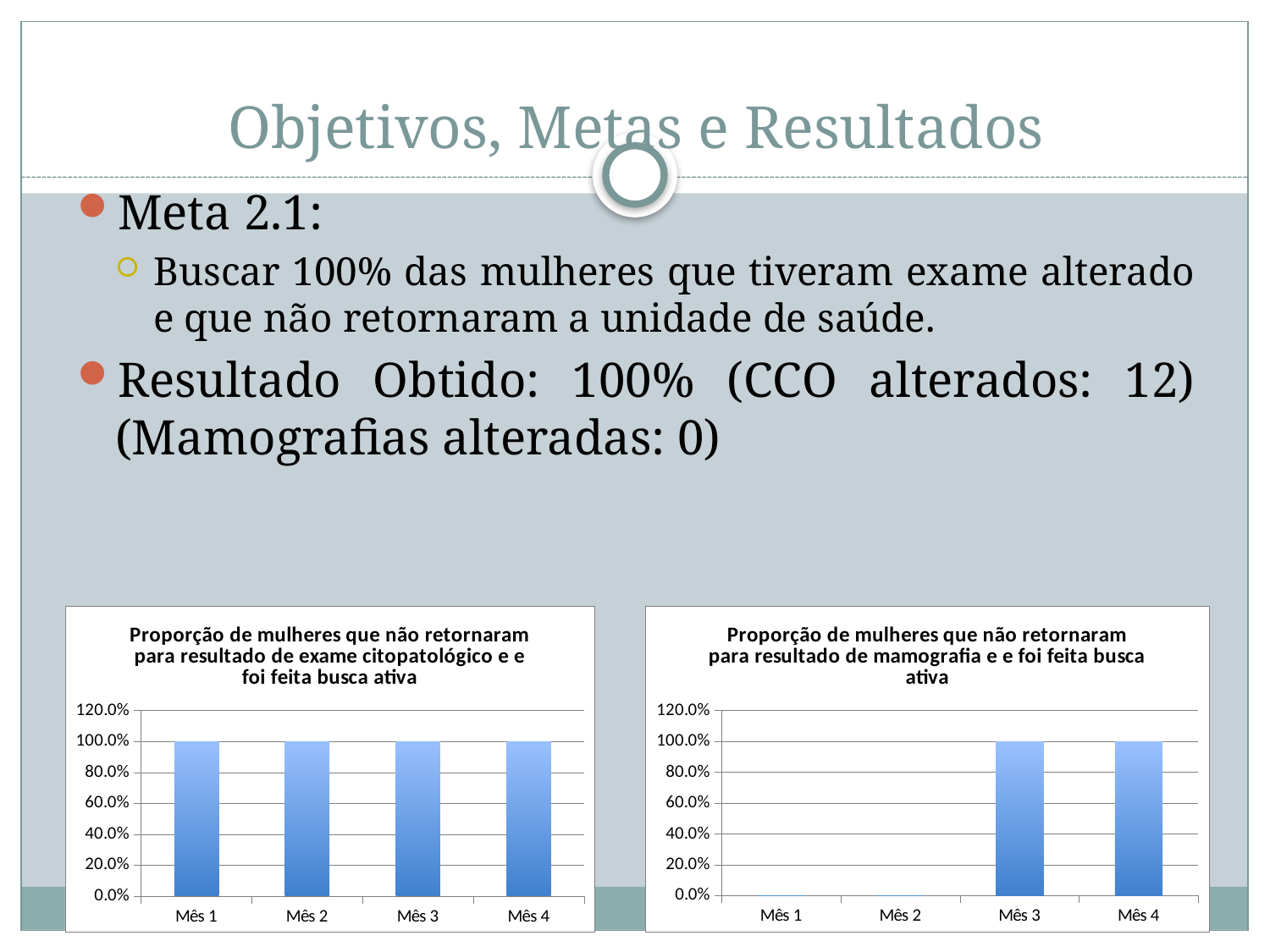
In the right chart (mamografia), which month has the lowest value, Mês 2 or Mês 4? Mês 2 In the right chart (mamografia), is the value for Mês 4 greater or less than 80.0%? greater In the right chart (mamografia), what is the value for Mês 3? 100.0% What is the highest value shown on the y axis of the left chart (exame citopatológico)? 120.0% In the right chart (mamografia), what is the difference between the values for Mês 4 and Mês 2? 100.0% In the left chart (exame citopatológico), what is the value for Mês 1? 100.0% In the left chart (exame citopatológico), what is the value for Mês 4? 100.0% What kind of chart is the right chart (mamografia)? bar chart In the right chart (mamografia), what is the value for Mês 1? 0.0% How many months are shown on the x axis of the left chart (exame citopatológico)? 4 In the left chart (exame citopatológico), do the values change from Mês 1 to Mês 4? No, they stay at 100.0% In the right chart (mamografia), do the values rise or fall from Mês 1 to Mês 4? rise